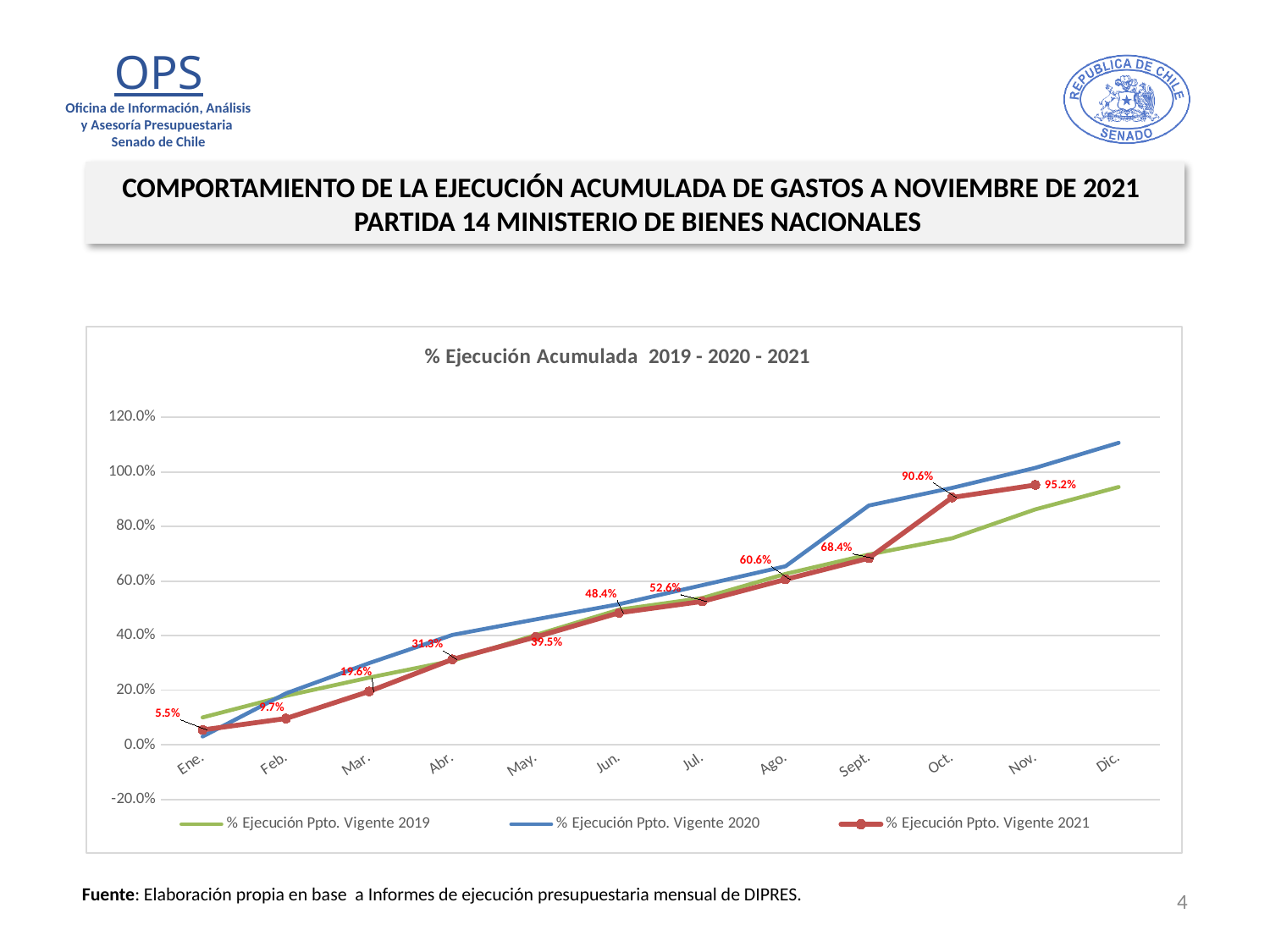
How many months are shown along the x axis? 12 What is the value of % Ejecución Ppto. Vigente 2021 in Oct.? 90.6% By how many percentage points did % Ejecución Ppto. Vigente 2021 increase from Sept. to Oct.? 22.2 percentage points Is the value for % Ejecución Ppto. Vigente 2020 in Dic. greater or less than 100.0%? greater Do the values of % Ejecución Ppto. Vigente 2021 rise or fall from Ene. to Nov.? Rise What kind of chart is shown on the slide? Line chart What is the value of % Ejecución Ppto. Vigente 2021 in Sept.? 68.4% How many series does the legend list? 3 What is the value of % Ejecución Ppto. Vigente 2021 in Nov.? 95.2% What is the value of % Ejecución Ppto. Vigente 2021 in Ene.? 5.5% By how many percentage points did % Ejecución Ppto. Vigente 2021 increase from Oct. to Nov.? 4.6 percentage points In Oct., which series is higher: % Ejecución Ppto. Vigente 2019 or % Ejecución Ppto. Vigente 2020? % Ejecución Ppto. Vigente 2020